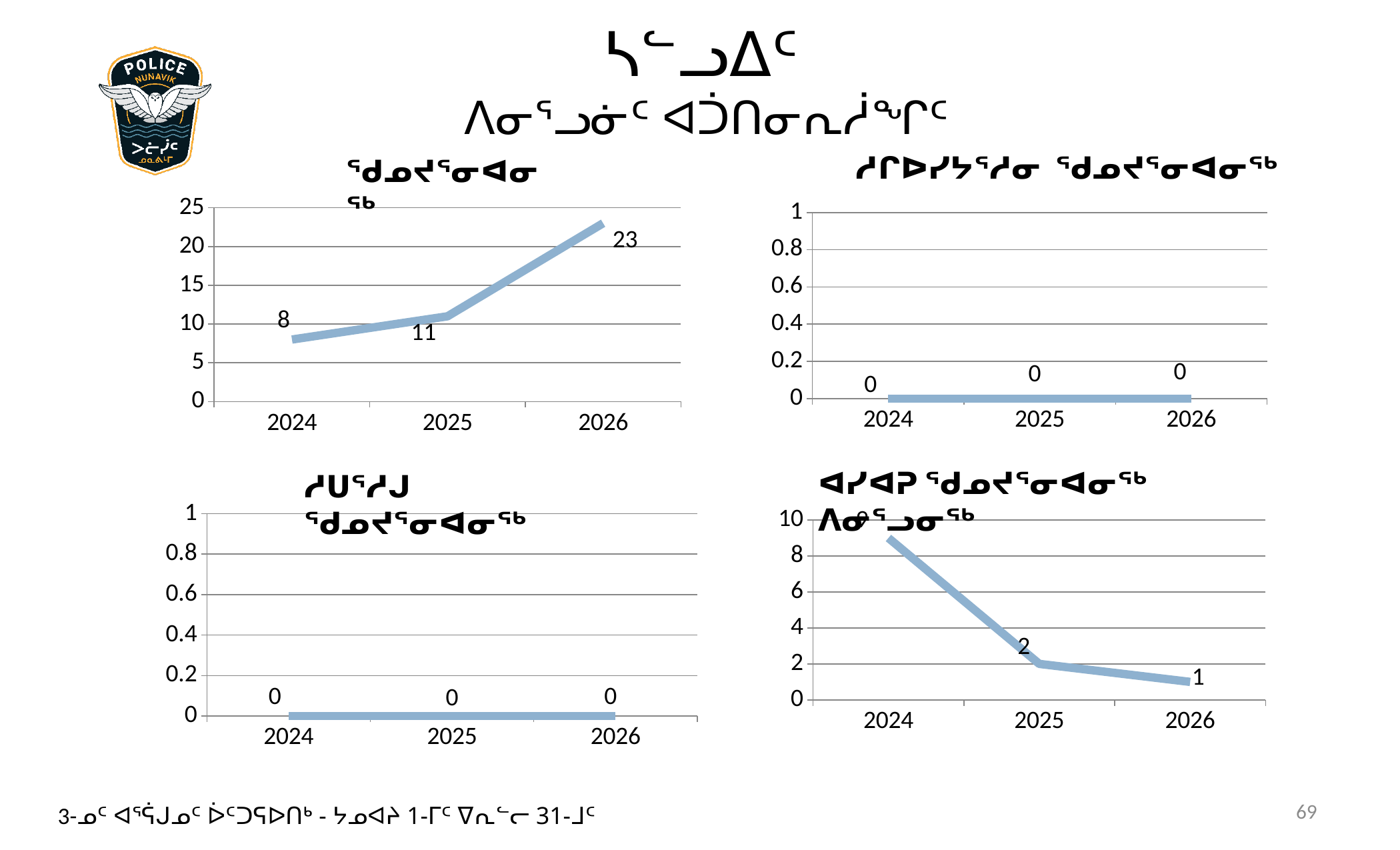
In the top-left chart, what is the value for 2026? 23 What kind of chart is the top-left chart? line chart In the bottom-right chart, what is the value for 2026? 1 In the top-left chart, what is the value for 2024? 8 In the top-left chart, which year has the highest value? 2026 In the top-left chart, do the values rise or fall from 2024 to 2026? rise In the bottom-right chart, is the value for 2024 greater or less than 6? greater In the bottom-right chart, what is the value for 2025? 2 In the top-right chart, what is the value for 2025? 0 In the bottom-right chart, do the values rise or fall from 2024 to 2026? fall In the top-left chart, what is the difference between the 2026 and 2025 values? 12 In the bottom-left chart, how many years are plotted on the x axis? 3